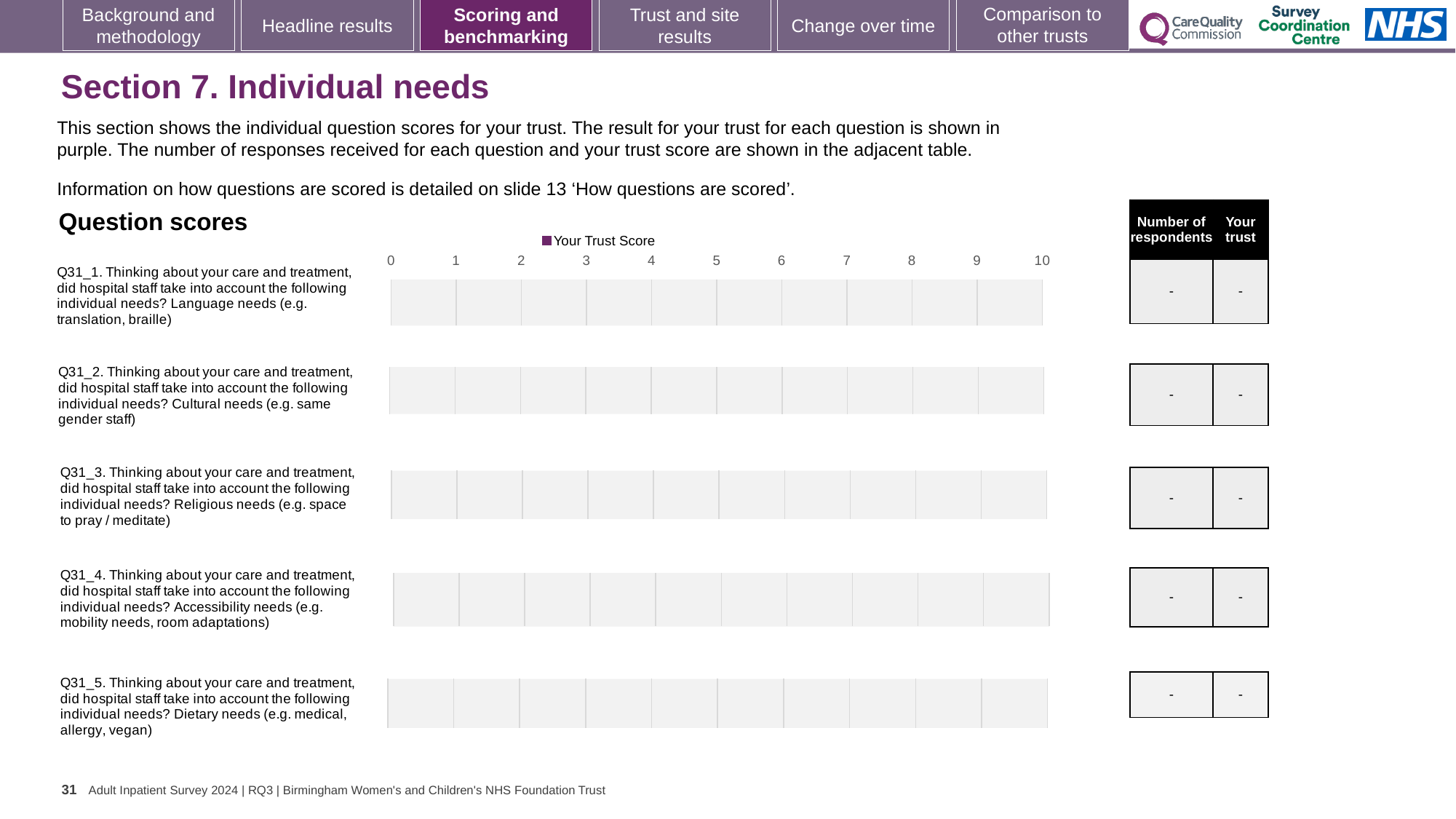
What is shown in the 'Number of respondents' column for Q31_1? - What is shown in the 'Your trust' column for Q31_3? - What is shown in the 'Your trust' column for Q31_5? - How many questions (categories) are listed on the chart? 5 How many series does the chart legend list? 1 What is the name of the series shown in the chart legend? Your Trust Score What kind of chart is used on the slide to show the question scores? bar chart What is the highest value shown on the chart's horizontal axis? 10